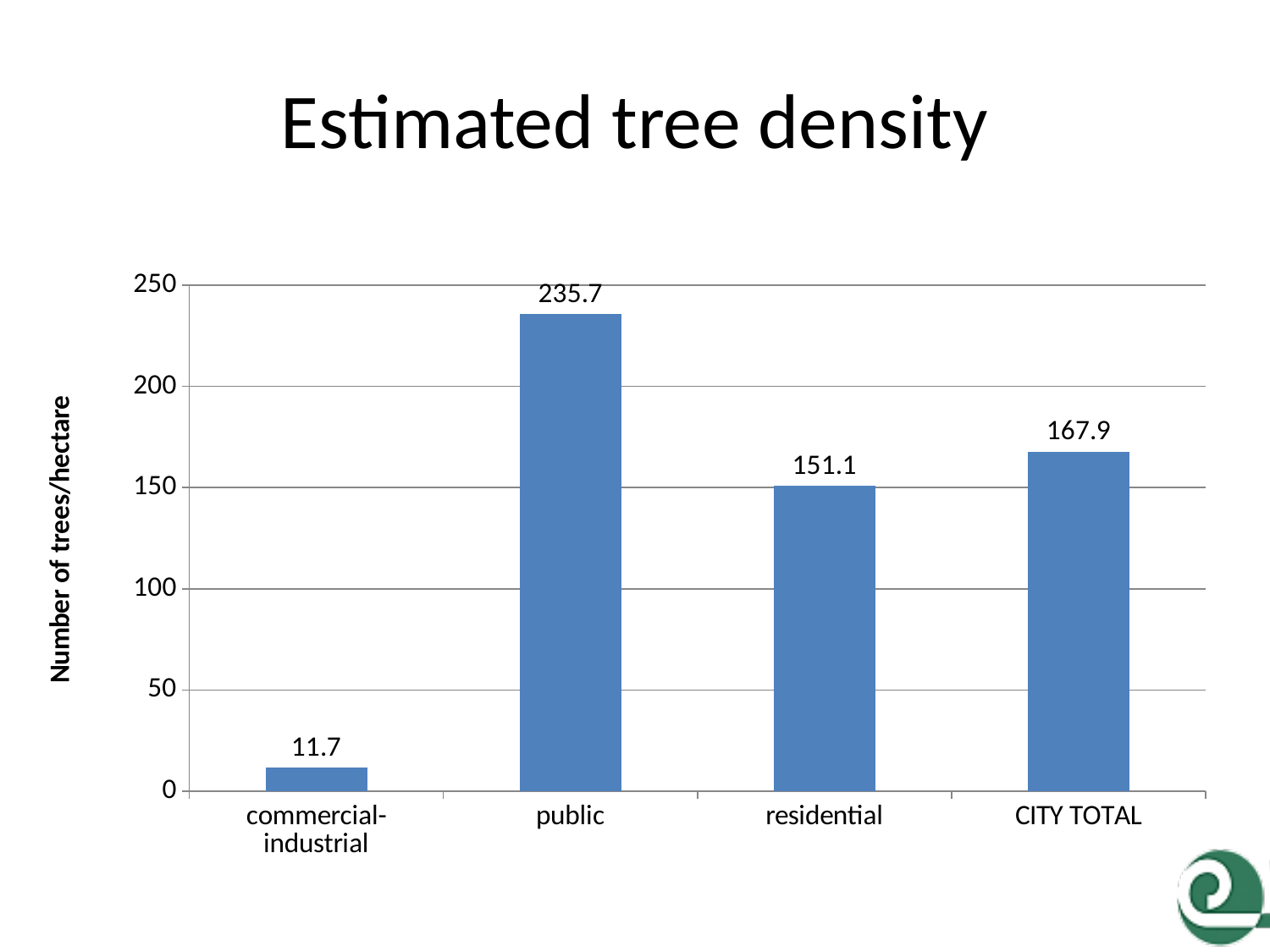
Which has a higher tree density, residential or CITY TOTAL? CITY TOTAL What is the estimated tree density for commercial-industrial land? 11.7 How many categories are shown on the x axis? 4 What is the CITY TOTAL estimated tree density? 167.9 What is the estimated tree density for residential land? 151.1 What is the label of the vertical axis? Number of trees/hectare Which category has the lowest estimated tree density? commercial-industrial What is the difference between the tree density for public land and residential land? 84.6 What kind of chart is shown on the slide? bar chart Which category has the highest estimated tree density? public What is the estimated tree density for public land? 235.7 What is the difference between the CITY TOTAL tree density and the residential tree density? 16.8